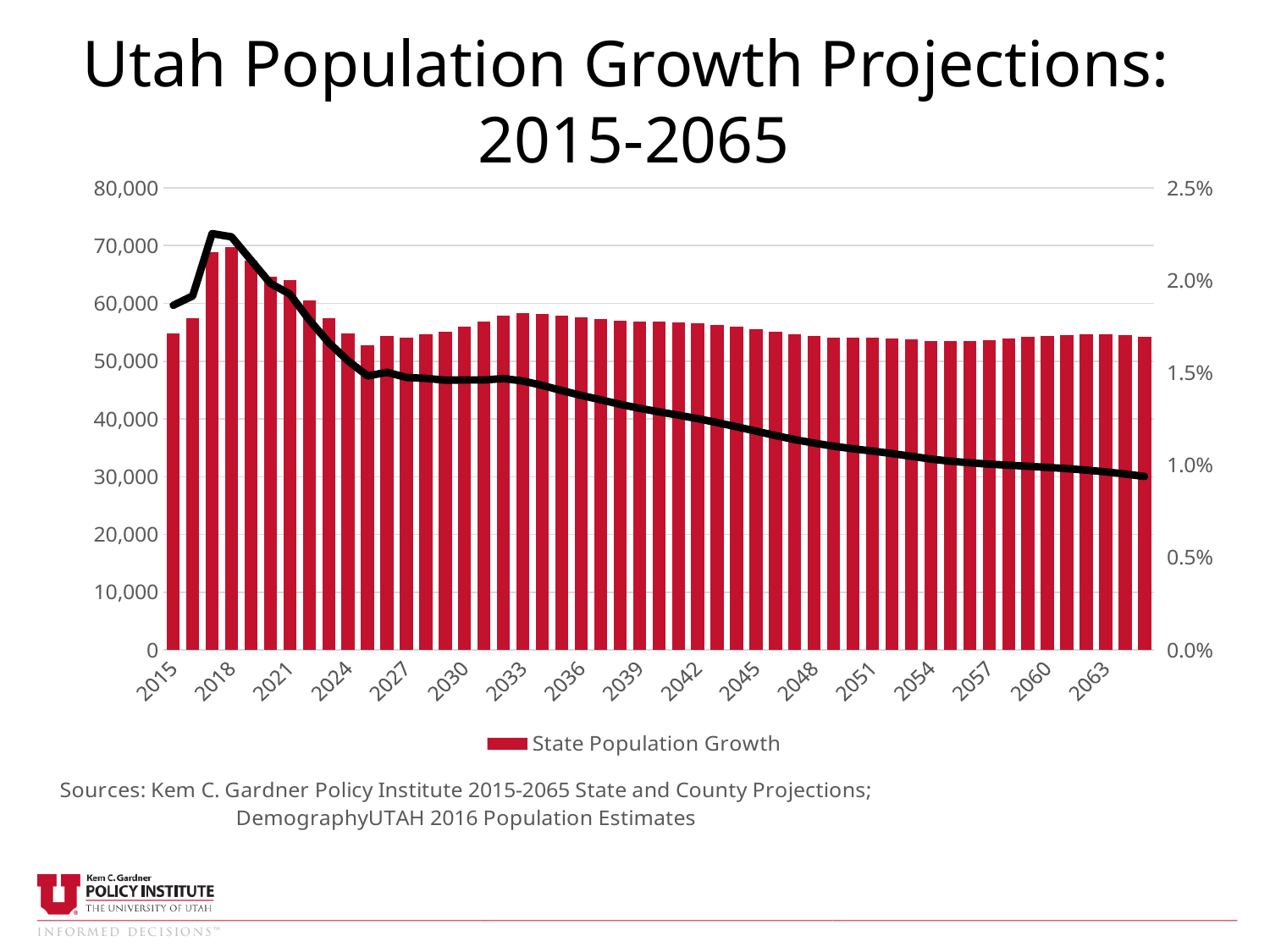
Which year has the larger State Population Growth bar, 2018 or 2027? 2018 Do the State Population Growth bars rise or fall from 2019 to 2026? fall Is the black line's value for 2018 greater or less than 2.0%? greater Is the State Population Growth bar for 2015 greater or less than 50,000? greater What is the title of the chart? Utah Population Growth Projections: 2015-2065 How many series does the legend list? 1 What series does the legend list? State Population Growth Does the black line rise or fall from 2018 to 2065? fall Is the State Population Growth bar for 2027 greater or less than 60,000? less What kind of chart is this? bar chart with a line overlay